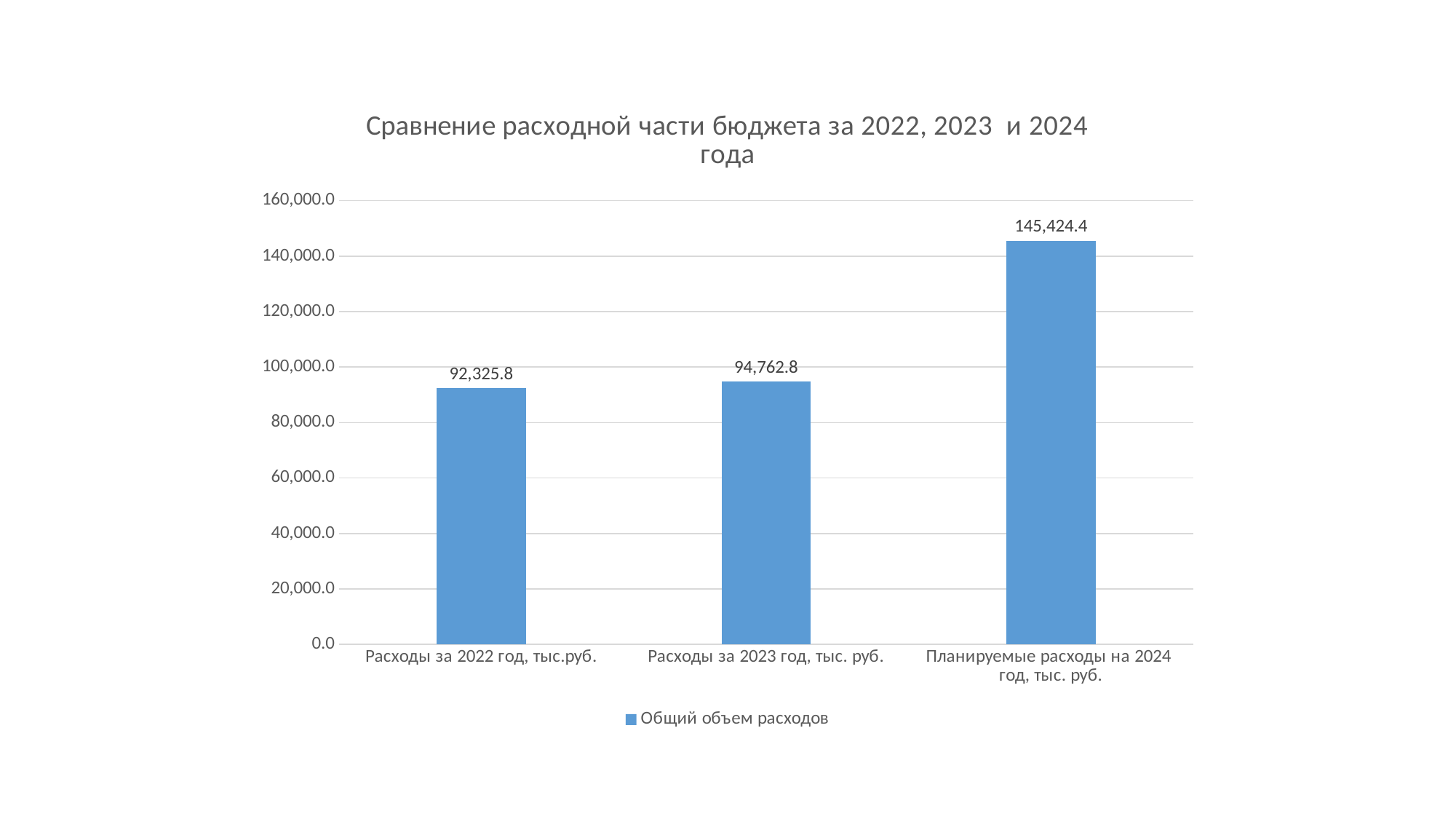
What is the difference between the value for Планируемые расходы на 2024 год, тыс. руб. and the value for Расходы за 2023 год, тыс. руб.? 50,661.6 What is the difference between the value for Расходы за 2023 год, тыс. руб. and the value for Расходы за 2022 год, тыс.руб.? 2,437.0 What is the value for Расходы за 2023 год, тыс. руб.? 94,762.8 What is the value for Планируемые расходы на 2024 год, тыс. руб.? 145,424.4 What is the title of the chart? Сравнение расходной части бюджета за 2022, 2023 и 2024 года Is the value for Планируемые расходы на 2024 год, тыс. руб. greater or less than 140,000.0? greater What is the value for Расходы за 2022 год, тыс.руб.? 92,325.8 Which category has the highest value? Планируемые расходы на 2024 год, тыс. руб. What kind of chart is shown on the slide? bar chart Which is larger: the value for Расходы за 2022 год, тыс.руб. or the value for Планируемые расходы на 2024 год, тыс. руб.? Планируемые расходы на 2024 год, тыс. руб. Which category has the lowest value? Расходы за 2022 год, тыс.руб. How many categories are shown on the x axis? 3